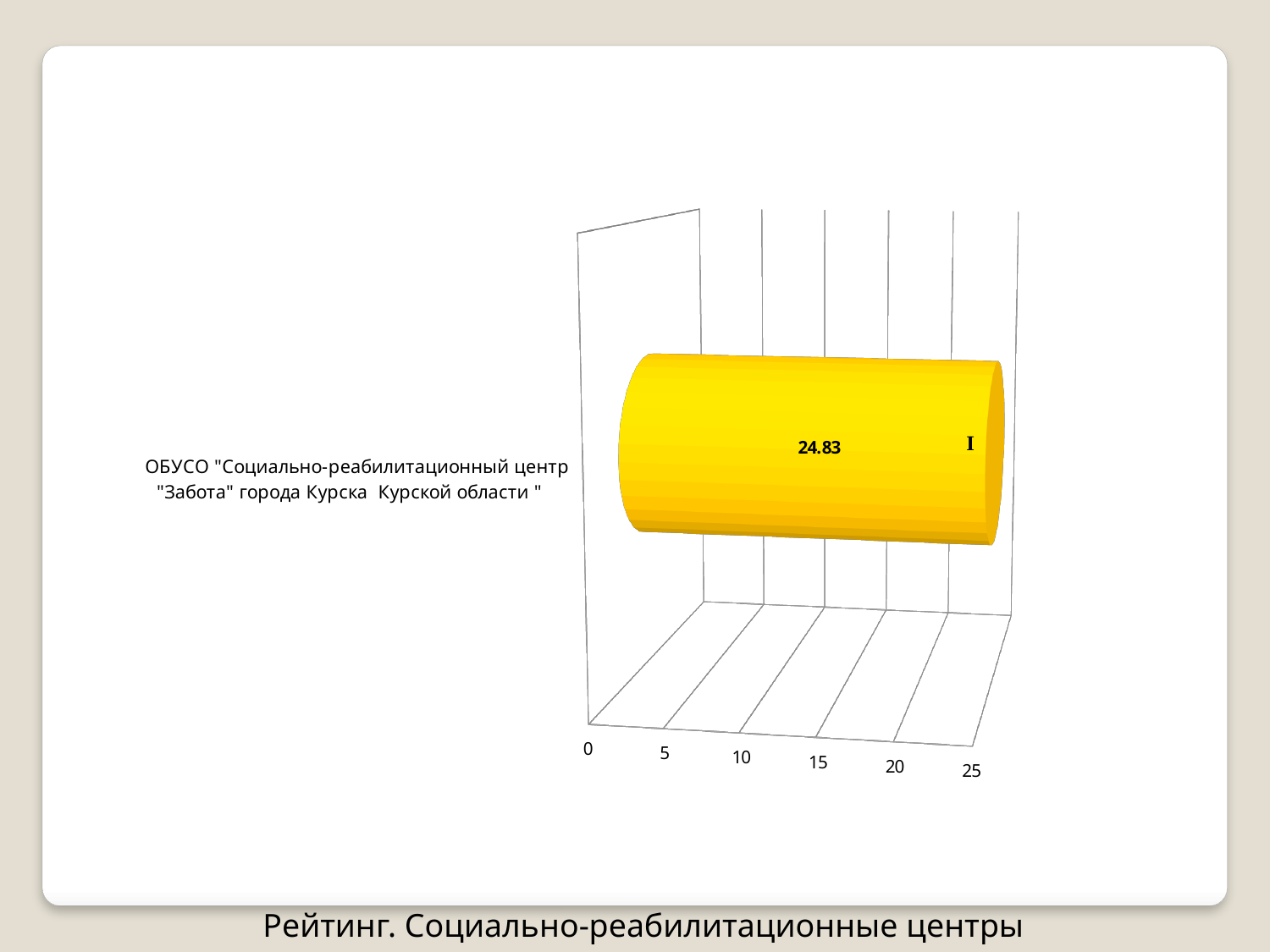
What rank label is printed at the end of the bar? I What kind of chart is shown on the slide? bar chart How many categories are plotted on the chart? 1 What is the name of the only category on the chart? ОБУСО "Социально-реабилитационный центр "Забота" города Курска Курской области" What is the value shown for ОБУСО "Социально-реабилитационный центр "Забота" города Курска Курской области"? 24.83 Is the value for ОБУСО "Социально-реабилитационный центр "Забота" города Курска Курской области" greater or less than 25? less What is the highest value shown on the value axis? 25 Is the value for ОБУСО "Социально-реабилитационный центр "Забота" города Курска Курской области" greater or less than 20? greater